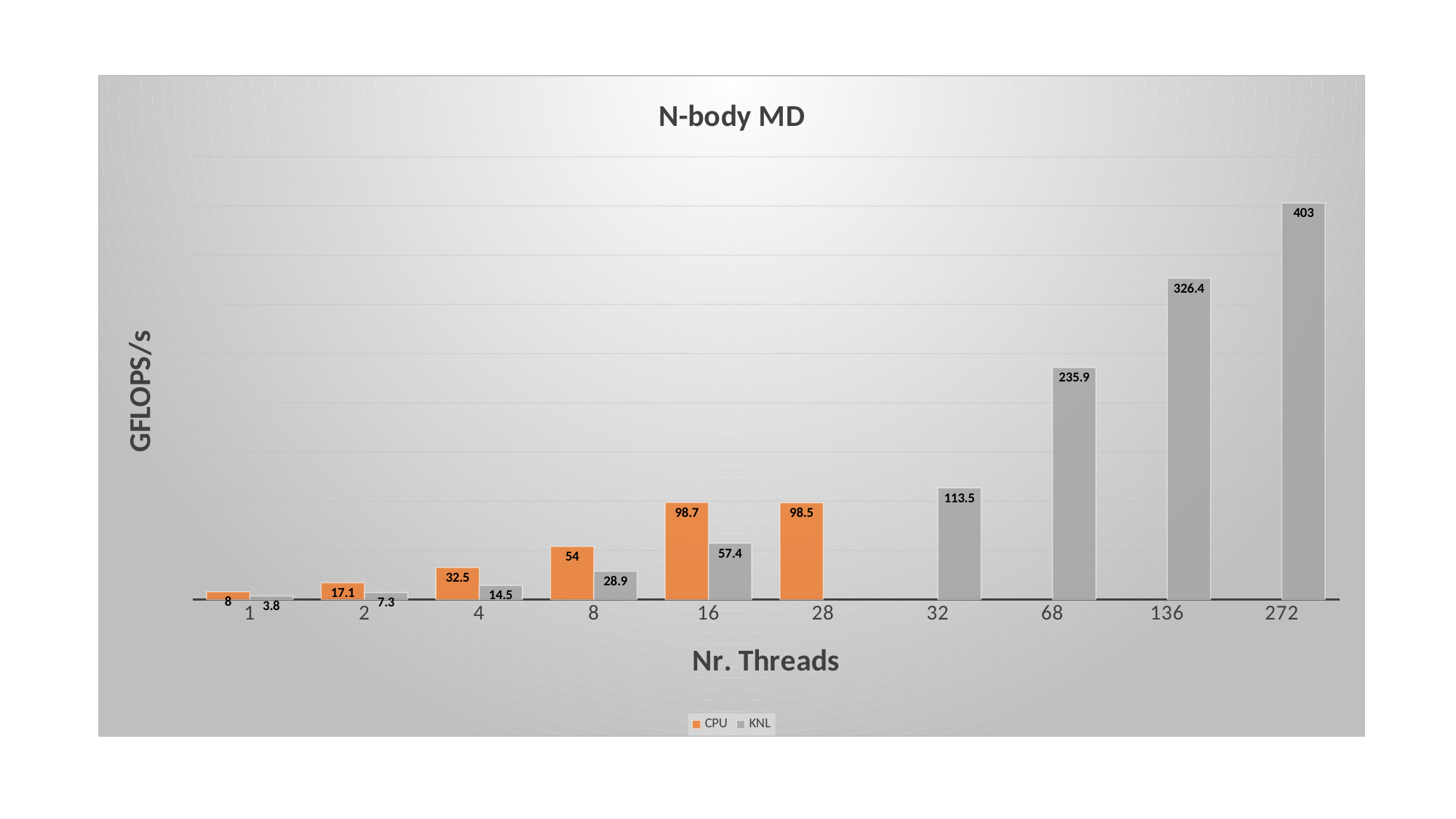
What is the title of the chart? N-body MD What kind of chart is this? bar chart What is the CPU value at 4 threads? 32.5 What is the CPU value at 16 threads? 98.7 What is the difference between the KNL values at 272 and 136 threads? 76.6 How many series does the legend list? 2 Which is larger at 16 threads, the CPU value or the KNL value? CPU At which number of threads is the CPU value lowest? 1 At which number of threads is the KNL value highest? 272 How many thread counts are shown on the x axis? 10 What is the KNL value at 8 threads? 28.9 What is the KNL value at 272 threads? 403